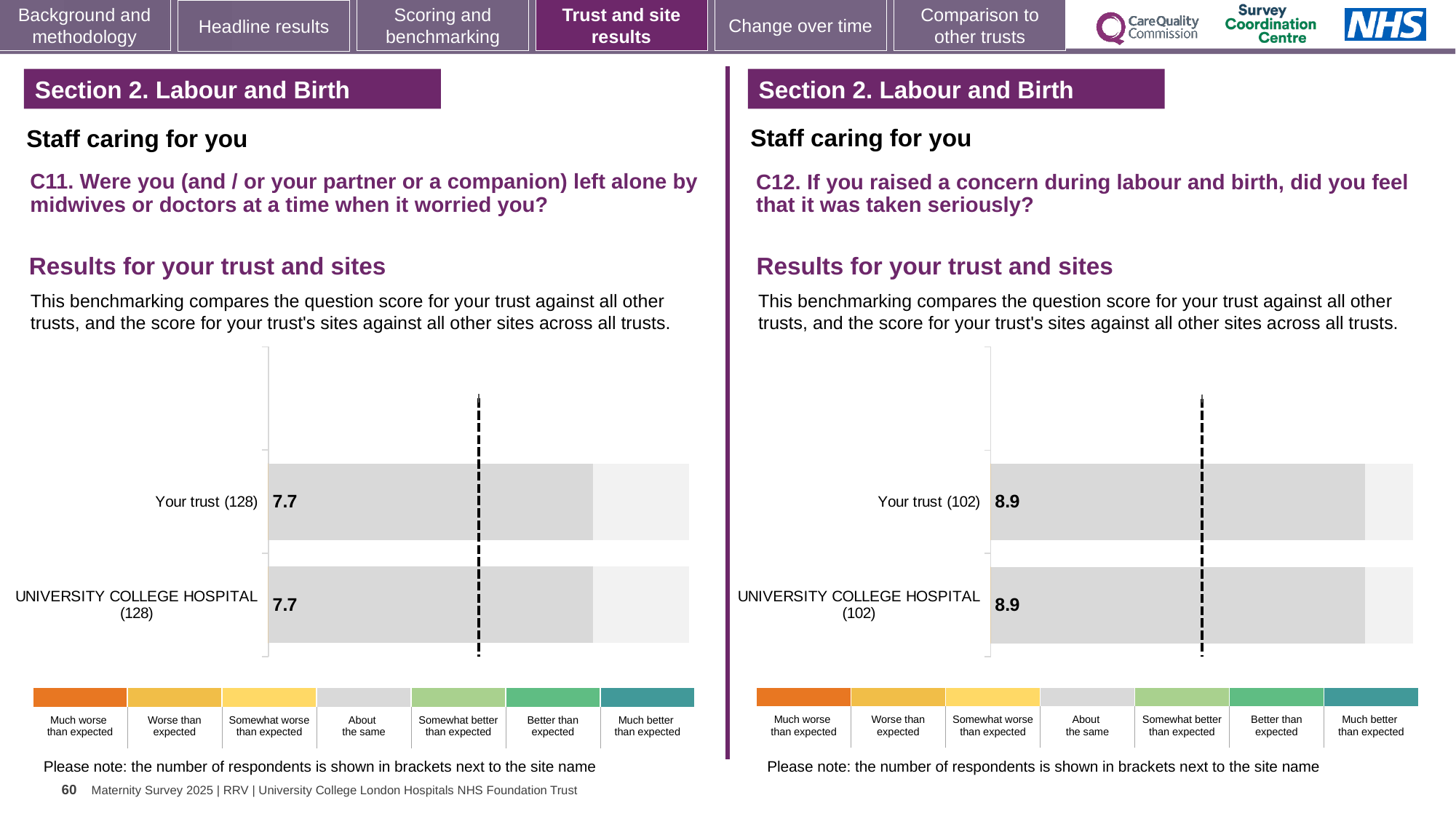
In the C11 chart on the left, which benchmark category does the grey colour of the bars correspond to in the legend? About the same How many respondents are shown in brackets for Your trust in the C12 chart on the right? 102 In the C11 chart on the left, what is the score for Your trust (128)? 7.7 How many bars are plotted in the C11 chart on the left? 2 In the C11 chart on the left, what is the score for UNIVERSITY COLLEGE HOSPITAL (128)? 7.7 In the C12 chart on the right, what is the difference between the score for Your trust and the score for UNIVERSITY COLLEGE HOSPITAL? 0 In the C12 chart on the right, what is the score for UNIVERSITY COLLEGE HOSPITAL (102)? 8.9 What kind of chart is used in the C11 chart on the left? Bar chart How many categories does the colour legend below the C12 chart on the right list? 7 How many bars are plotted in the C12 chart on the right? 2 In the C11 chart on the left, what is the difference between the score for Your trust and the score for UNIVERSITY COLLEGE HOSPITAL? 0 In the C12 chart on the right, what is the score for Your trust (102)? 8.9